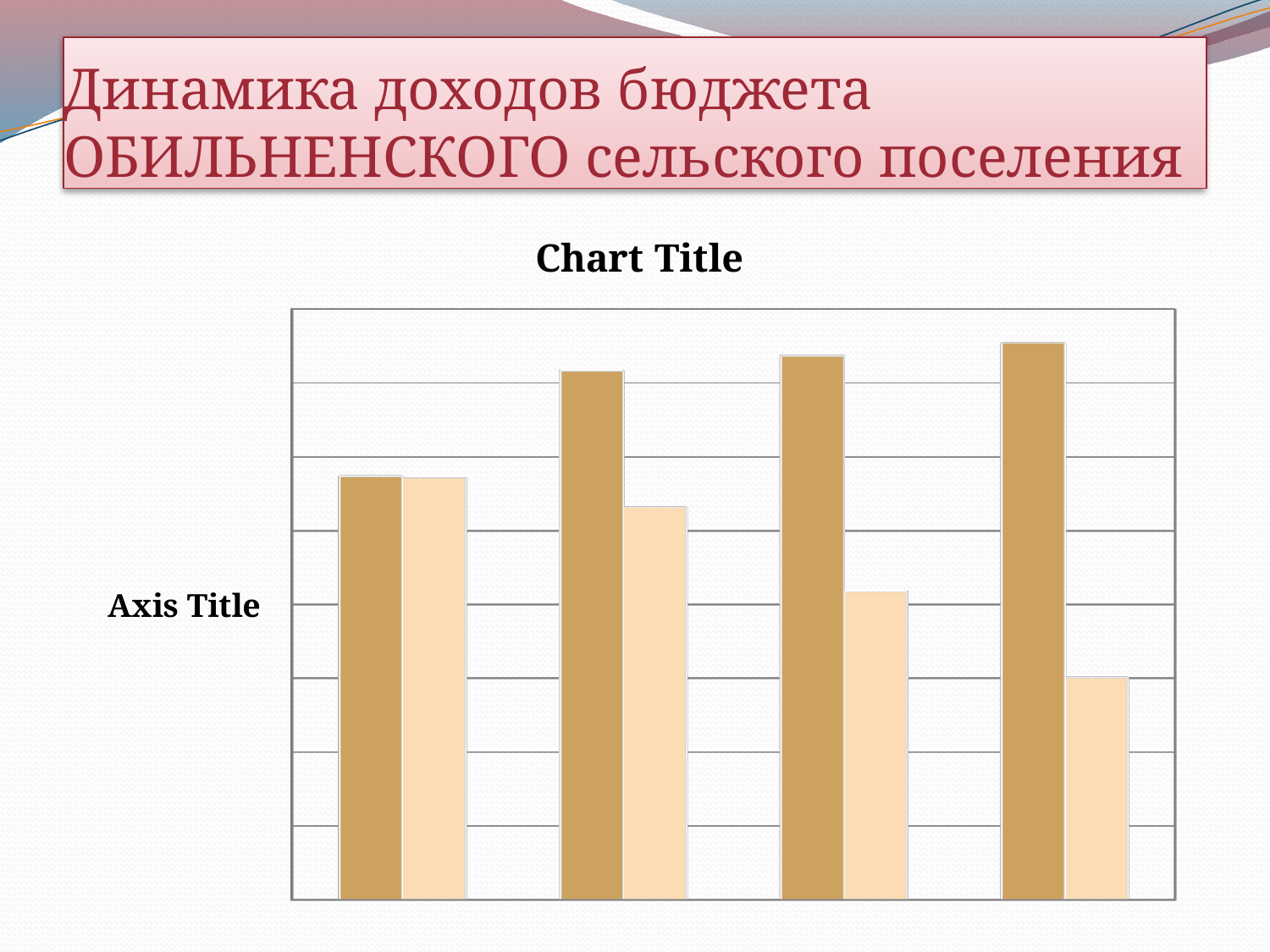
What is the title printed above the chart? Chart Title In the fourth group, which bar is taller: the dark brown bar or the light beige bar? dark brown bar What text is shown as the vertical axis title? Axis Title Which group has the shortest light beige bar: the first, second, third or fourth? fourth Do the dark brown bars rise or fall from left to right across the groups? rise How many groups of bars are plotted in the chart? 4 Do the light beige bars rise or fall from left to right across the groups? fall Which group has the tallest light beige bar: the first, second, third or fourth? first Which group has the shortest dark brown bar: the first, second, third or fourth? first What kind of chart is shown on the slide? bar chart Which group has the tallest dark brown bar: the first, second, third or fourth? fourth How many bars are there in each group? 2